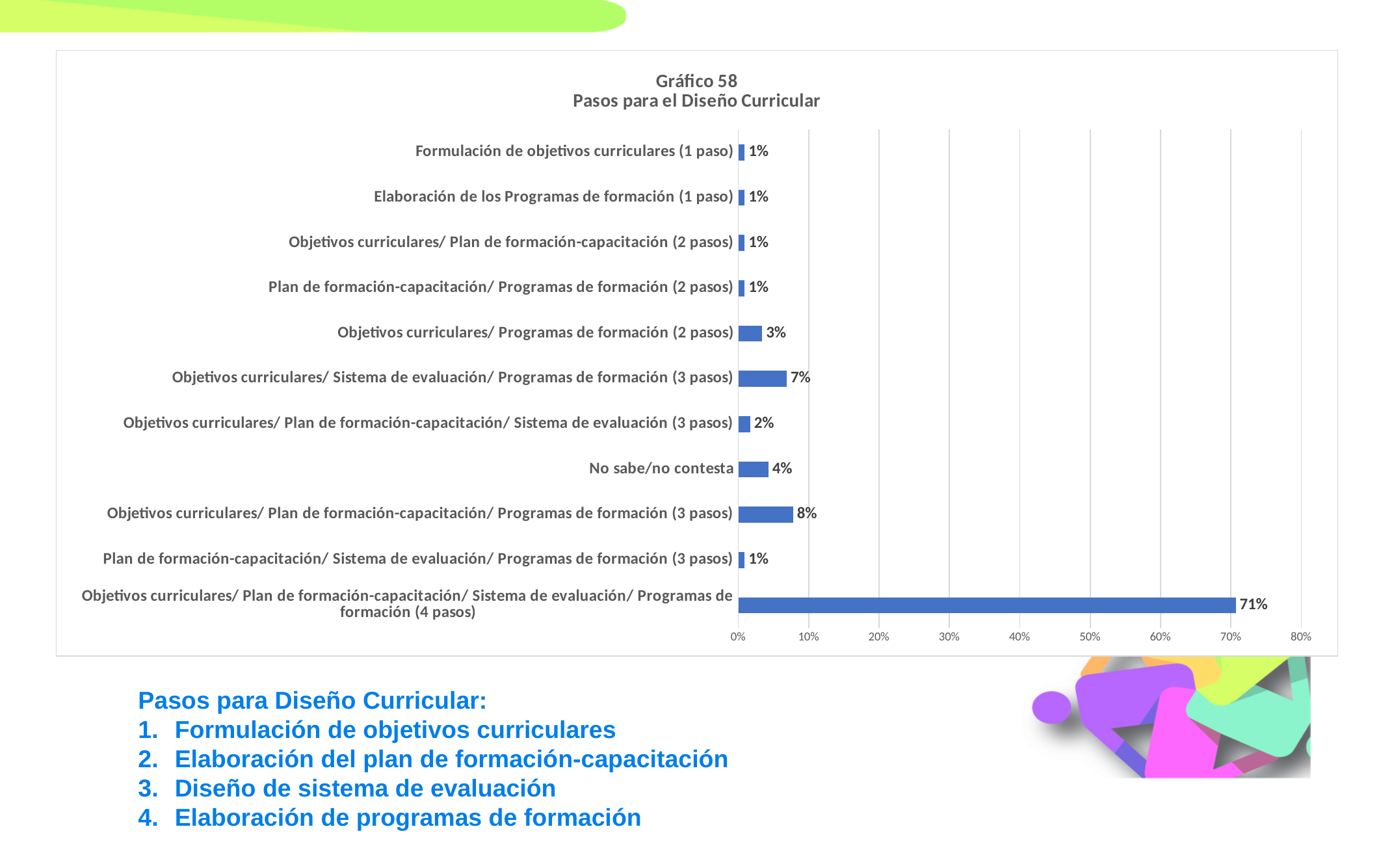
What is the value for 'Objetivos curriculares/ Plan de formación-capacitación/ Sistema de evaluación (3 pasos)'? 2% Which is larger: the value for 'No sabe/no contesta' or the value for 'Objetivos curriculares/ Programas de formación (2 pasos)'? No sabe/no contesta What is the value for 'Objetivos curriculares/ Plan de formación-capacitación/ Sistema de evaluación/ Programas de formación (4 pasos)'? 71% What kind of chart is shown on the slide? bar chart Which category has the highest value? Objetivos curriculares/ Plan de formación-capacitación/ Sistema de evaluación/ Programas de formación (4 pasos) What is the title of the chart? Gráfico 58 Pasos para el Diseño Curricular What is the value for 'Objetivos curriculares/ Sistema de evaluación/ Programas de formación (3 pasos)'? 7% What is the value for 'Objetivos curriculares/ Programas de formación (2 pasos)'? 3% What is the difference between the value for 'Objetivos curriculares/ Plan de formación-capacitación/ Programas de formación (3 pasos)' and the value for 'Objetivos curriculares/ Sistema de evaluación/ Programas de formación (3 pasos)'? 1% What is the value for 'No sabe/no contesta'? 4% How many categories are shown in the chart? 11 Is the value for 'Objetivos curriculares/ Plan de formación-capacitación/ Sistema de evaluación/ Programas de formación (4 pasos)' greater or less than 60%? greater